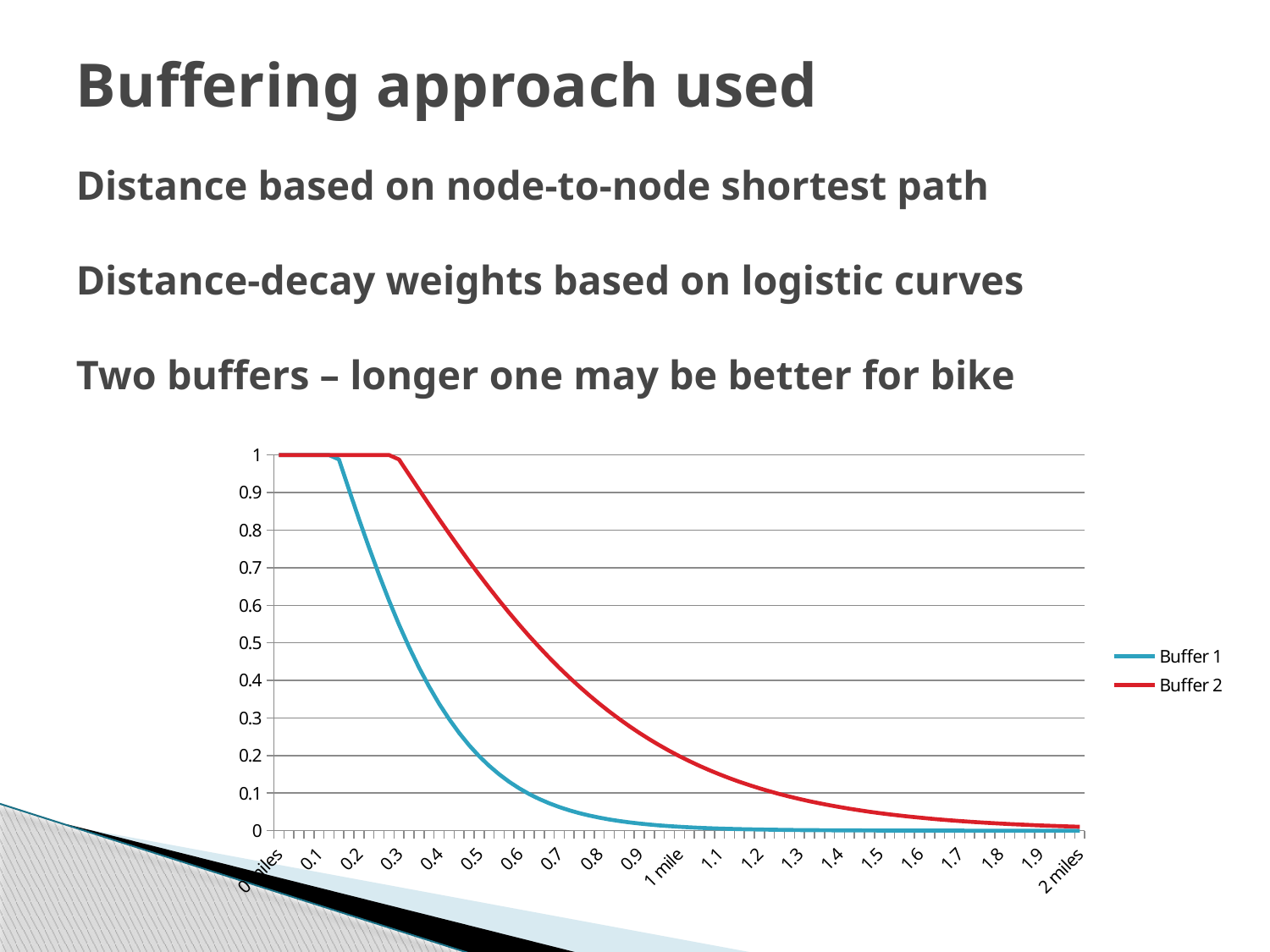
What is the value of Buffer 2 at 0 miles? 1 Is the value for Buffer 2 at 0.5 miles greater or less than 0.5? greater Do the Buffer 2 values rise or fall as distance increases along the x axis? fall What are the two series named in the legend? Buffer 1 and Buffer 2 Is the value for Buffer 1 at 0.2 miles greater or less than 0.5? greater What kind of chart is shown on the slide? line chart At 1 mile, which series has the larger value, Buffer 1 or Buffer 2? Buffer 2 What colour is the Buffer 2 line? red Is the value for Buffer 1 at 0.5 miles greater or less than 0.5? less How many series does the legend list? 2 What is the value of Buffer 1 at 0 miles? 1